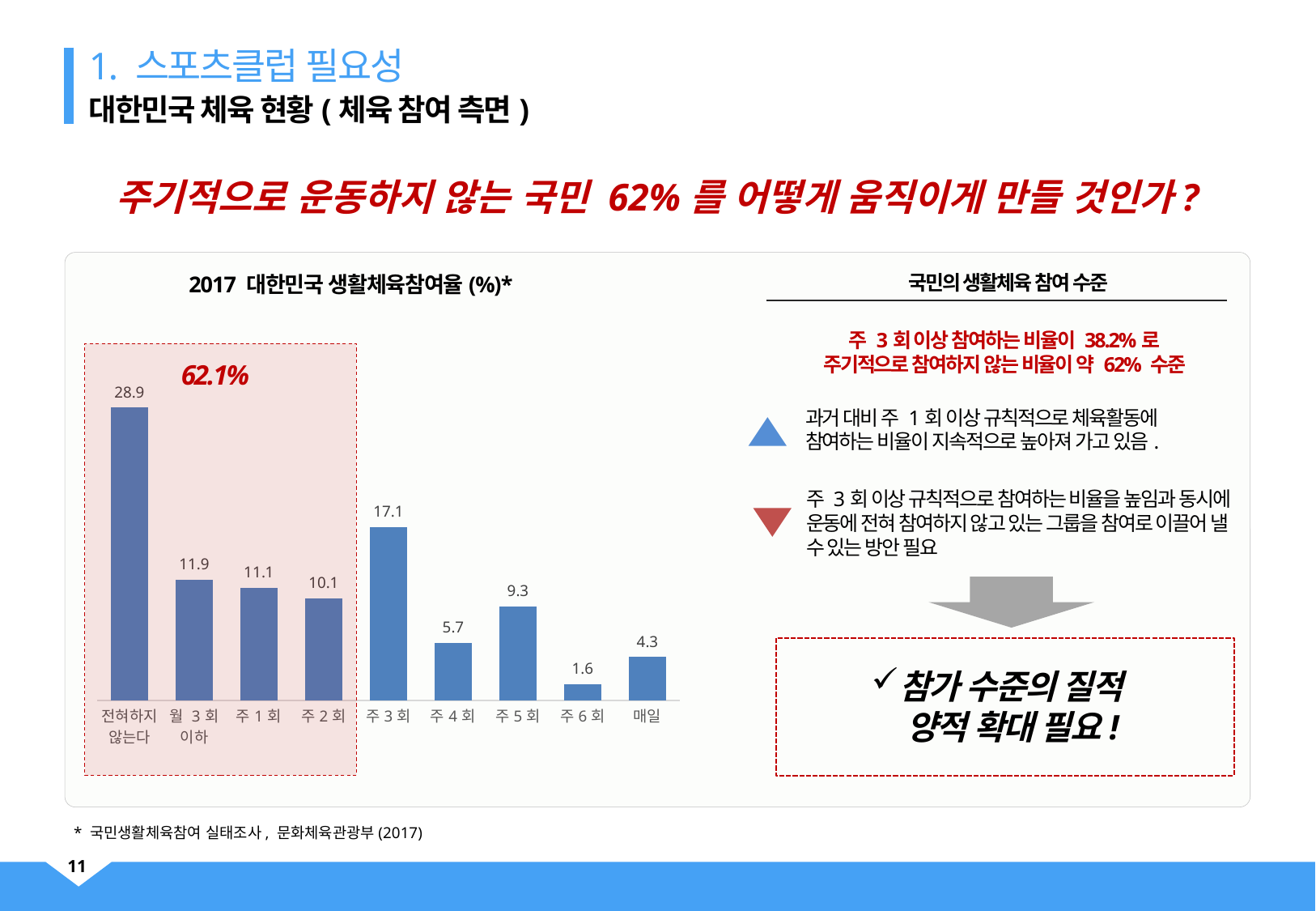
Which category has the highest value? 전혀하지 않는다 What is the difference between the values for 주 5회 and 주 4회? 3.6 What kind of chart is shown on the slide? Bar chart What percentage is printed inside the red dashed box highlighting the first four bars? 62.1% Which category has the lowest value? 주 6회 What is the difference between the values for 전혀하지 않는다 and 주 3회? 11.8 What is the value for 전혀하지 않는다? 28.9 Which is larger, the value for 월 3회 이하 or the value for 주 2회? 월 3회 이하 What is the value for 주 6회? 1.6 What is the value for 주 3회? 17.1 What is the value for 매일? 4.3 How many categories are shown in the chart? 9